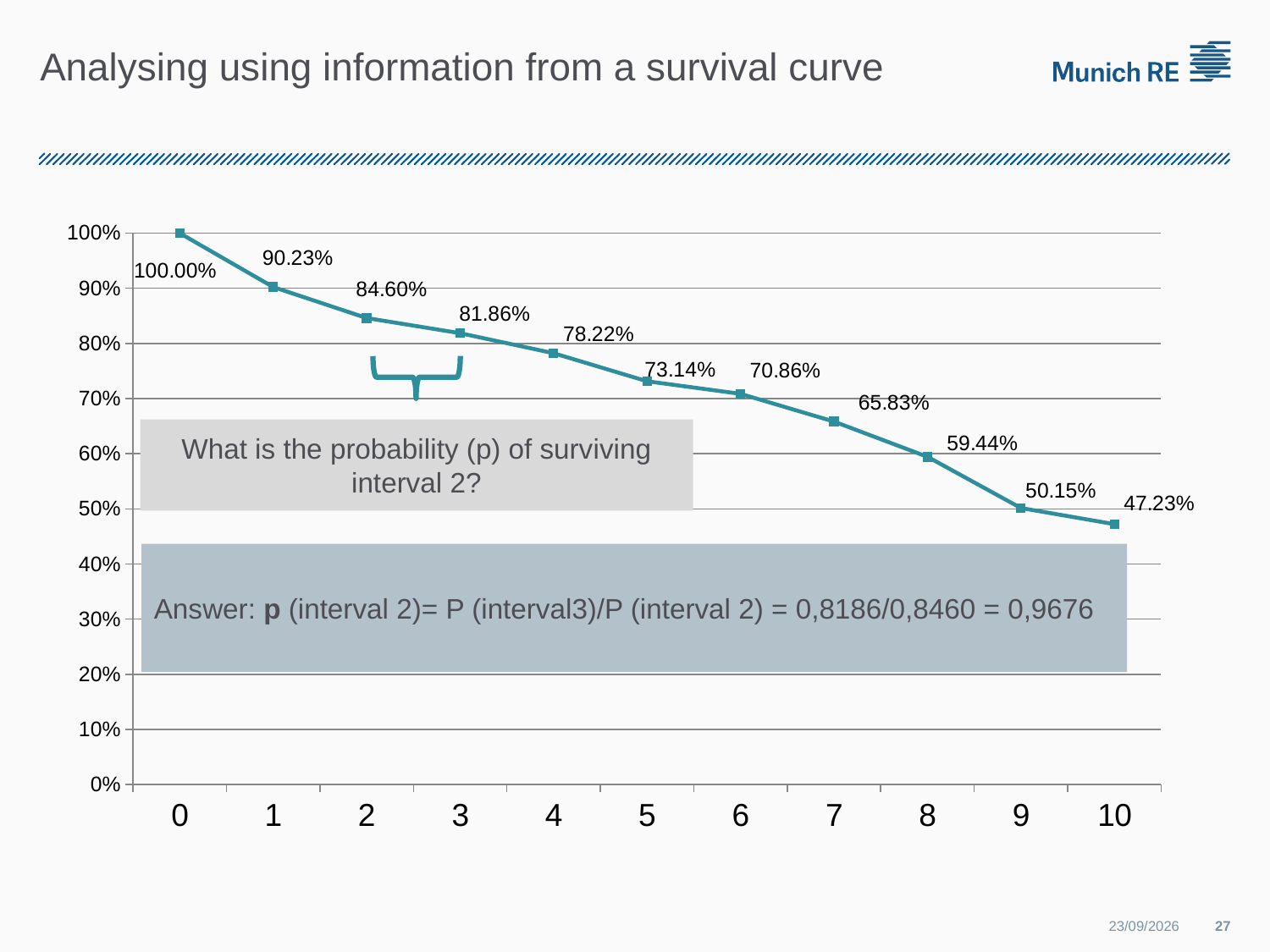
What is the difference between the values at x = 2 and x = 3? 2.74% At which x value is the survival curve highest? 0 What is the survival value at x = 7? 65.83% What is the survival value at x = 10? 47.23% Which is larger, the value at x = 5 or the value at x = 6? x = 5 What is the title of the slide containing the chart? Analysing using information from a survival curve At which x value is the survival curve lowest? 10 How many data points are plotted on the curve? 11 Do the values rise or fall as x increases from 0 to 10? fall What is the difference between the values at x = 8 and x = 9? 9.29% What is the survival value at x = 3? 81.86% What kind of chart is shown on the slide? line chart